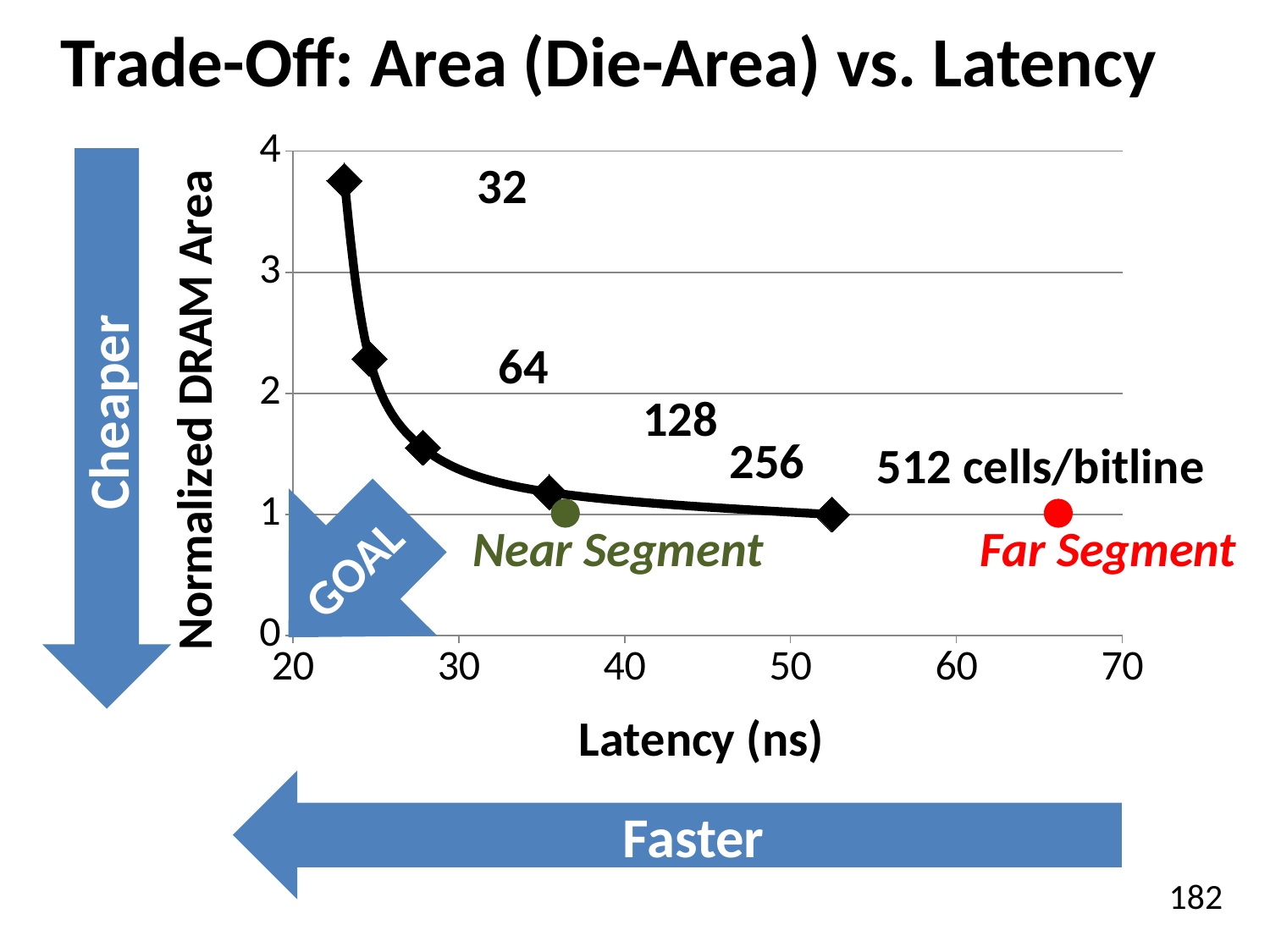
Is the normalized DRAM area for 32 cells/bitline greater or less than 3? greater Is the normalized DRAM area for 128 cells/bitline greater or less than 2? less What is the label of the x axis? Latency (ns) Is the latency of the Far Segment point greater or less than 60 ns? greater Which cells/bitline configuration has the highest normalized DRAM area? 32 How many black diamond data points are plotted on the curve? 5 What kind of chart is shown on the slide? line chart Which cells/bitline configuration has the lowest normalized DRAM area? 512 As latency increases along the x axis, does the normalized DRAM area rise or fall? fall Which has a larger normalized DRAM area, 64 cells/bitline or 128 cells/bitline? 64 cells/bitline